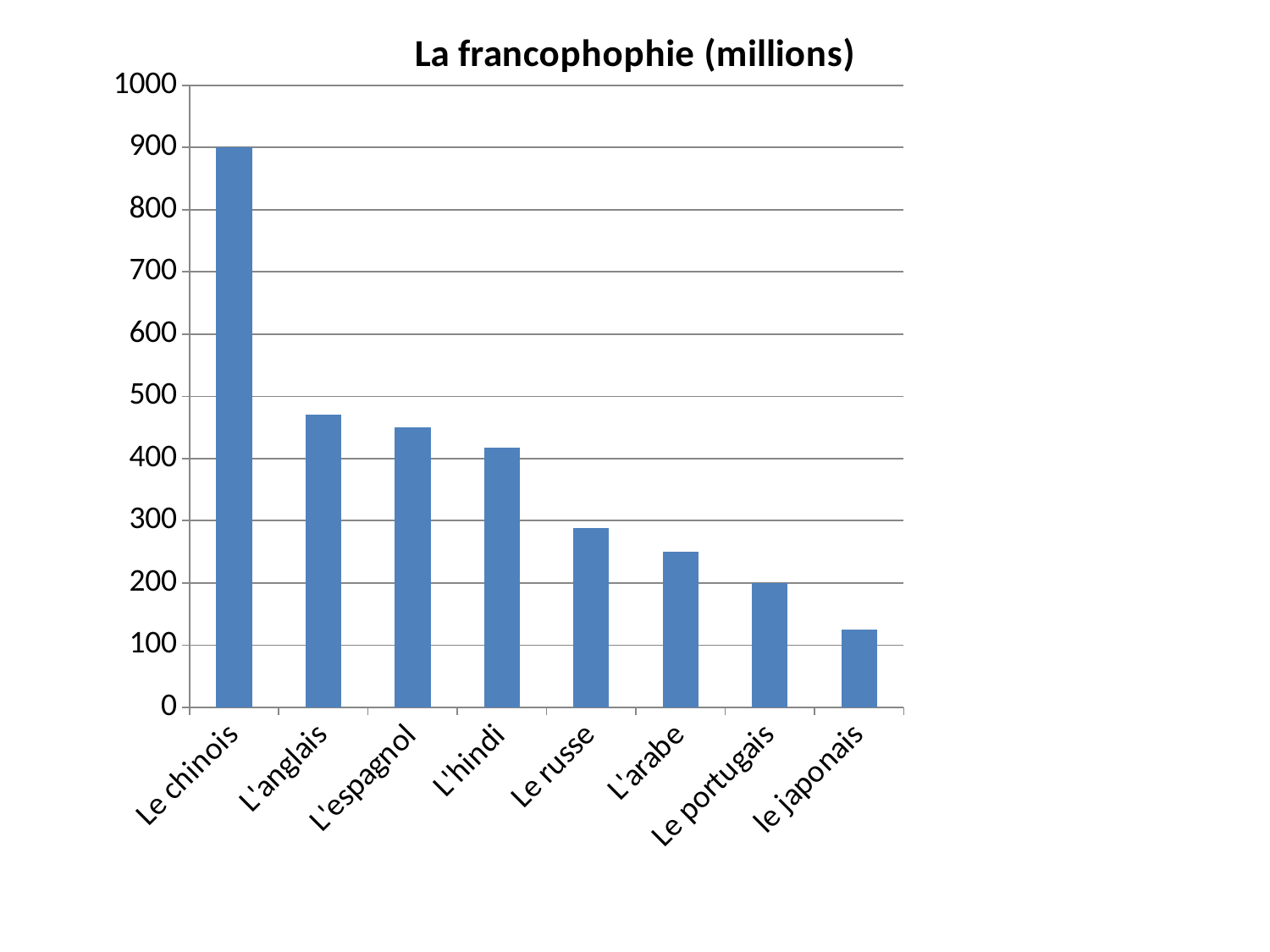
What is the value for Le portugais? 200 What kind of chart is shown on the slide? Bar chart Is the value for L'anglais greater or less than 500? less Which has the larger value, Le russe or L'arabe? Le russe Which language has the highest value in the chart? Le chinois What is the value for Le chinois? 900 Which language has the lowest value in the chart? le japonais Is the value for Le russe greater or less than 300? less Do the values rise or fall from left to right along the x axis? Fall How many languages are shown on the x axis of the chart? 8 Is the value for L'hindi greater or less than 400? greater What is the title of the chart? La francophophie (millions)